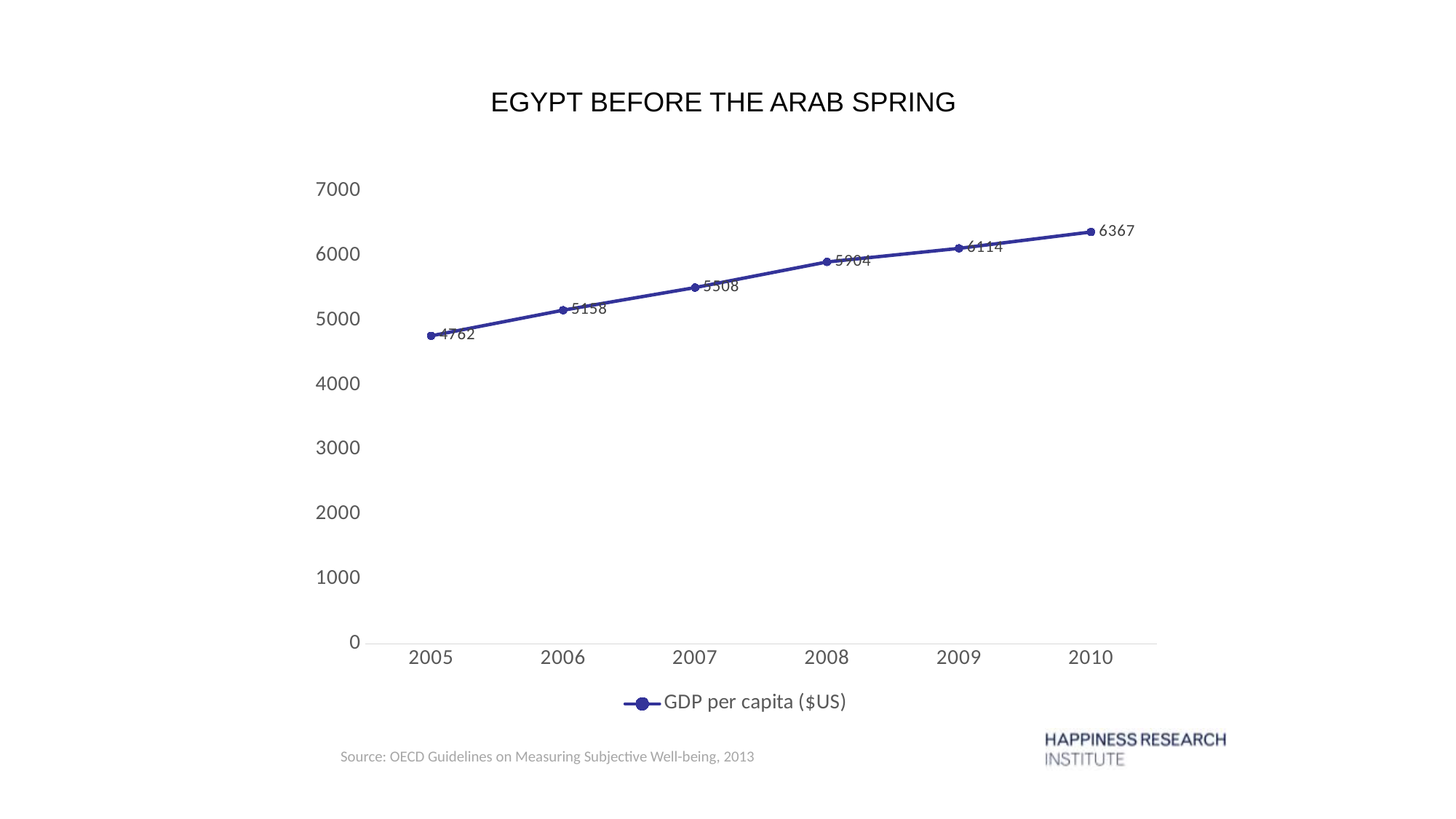
Which year has a higher GDP per capita, 2007 or 2009? 2009 What is the GDP per capita ($US) for 2008? 5904 What is the GDP per capita ($US) for 2010? 6367 How many years are plotted on the chart? 6 What kind of chart is shown on the slide? line chart Is the value for 2006 greater or less than 5000? greater Which year has the lowest GDP per capita? 2005 What is the GDP per capita ($US) for 2005? 4762 How many series does the legend list? 1 What is the difference in GDP per capita between 2010 and 2005? 1605 Does GDP per capita rise or fall from 2005 to 2010? rise Which year has the highest GDP per capita? 2010